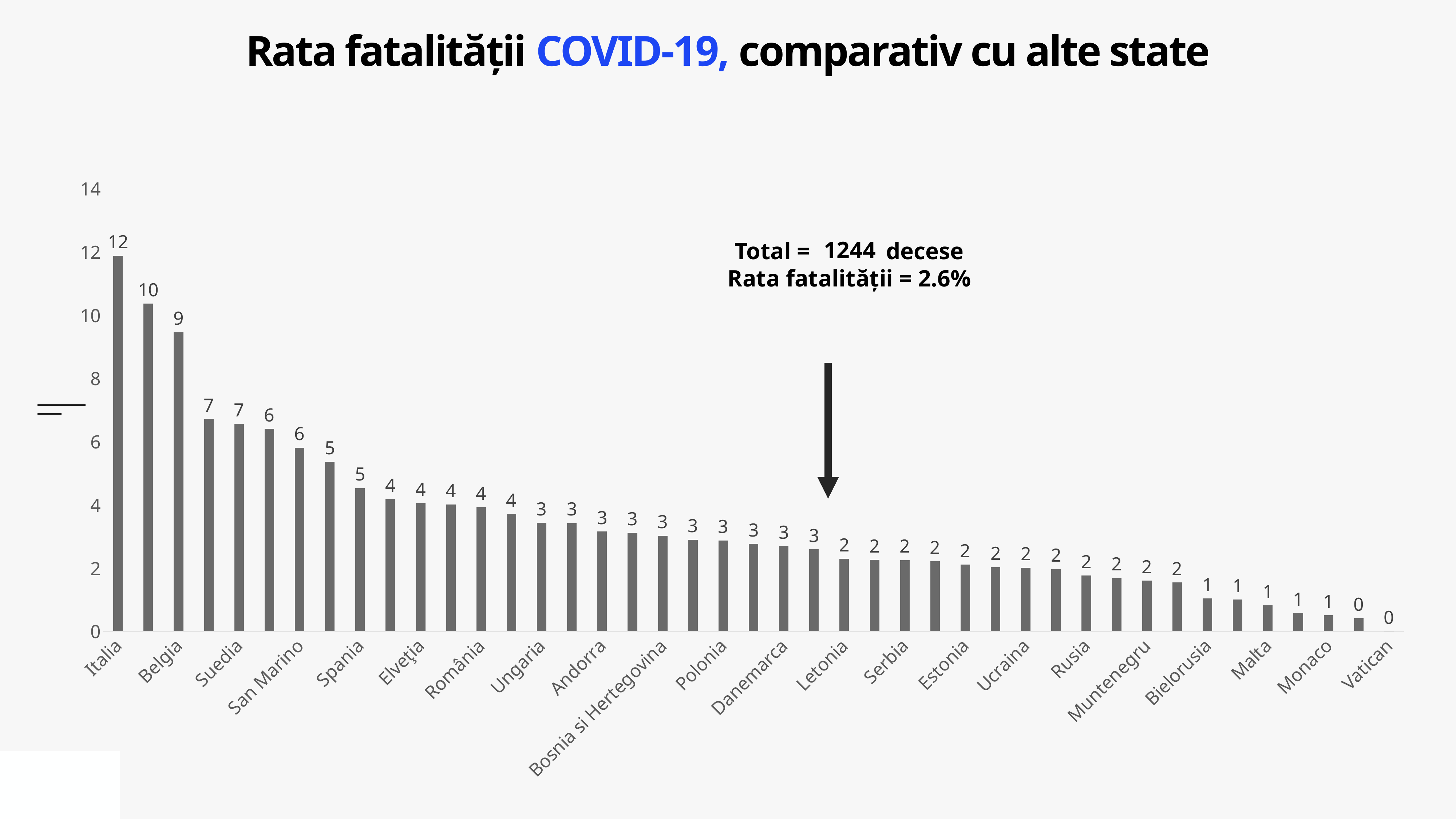
What is the difference between the values for Italia and Vatican? 12 Which has a larger value, Italia or Vatican? Italia Do the bar values rise or fall from left to right along the x axis? fall What fatality rate is stated in the text annotation on the chart? 2.6% What is the title of the chart on the slide? Rata fatalității COVID-19, comparativ cu alte state Is the value for Italia greater or less than 10? greater Which country has the lowest fatality rate in the chart? Vatican What is the value shown for Italia? 12 What is the highest data label value shown on any bar? 12 Which country has the highest fatality rate in the chart? Italia What is the value shown for Vatican? 0 What type of chart is shown on the slide? bar chart